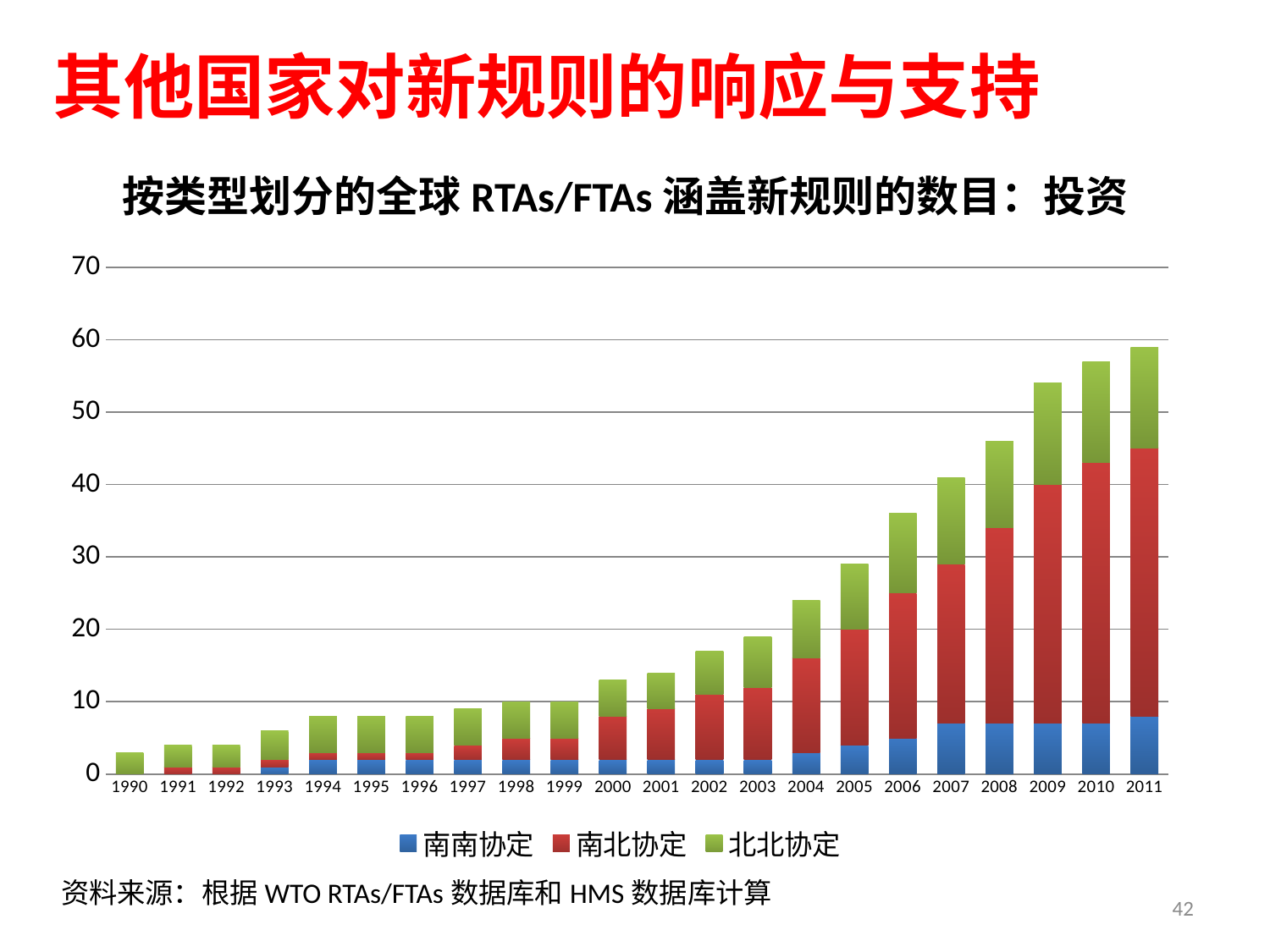
Is the total bar height for 2000 greater or less than 10? greater Which year has the tallest stacked bar in the chart? 2011 What kind of chart is shown on the slide? stacked bar chart Do the total bar heights generally rise or fall from 1990 to 2011? rise Is the total bar height for 2011 greater or less than 50? greater Is the total bar height for 2004 greater or less than 20? greater How many years are shown along the x axis of the chart? 22 What is the title of the chart? 按类型划分的全球 RTAs/FTAs 涵盖新规则的数目：投资 Which year has the taller stacked bar, 2008 or 2006? 2008 How many series does the chart's legend list? 3 Which series is shown in blue in the chart's legend? 南南协定